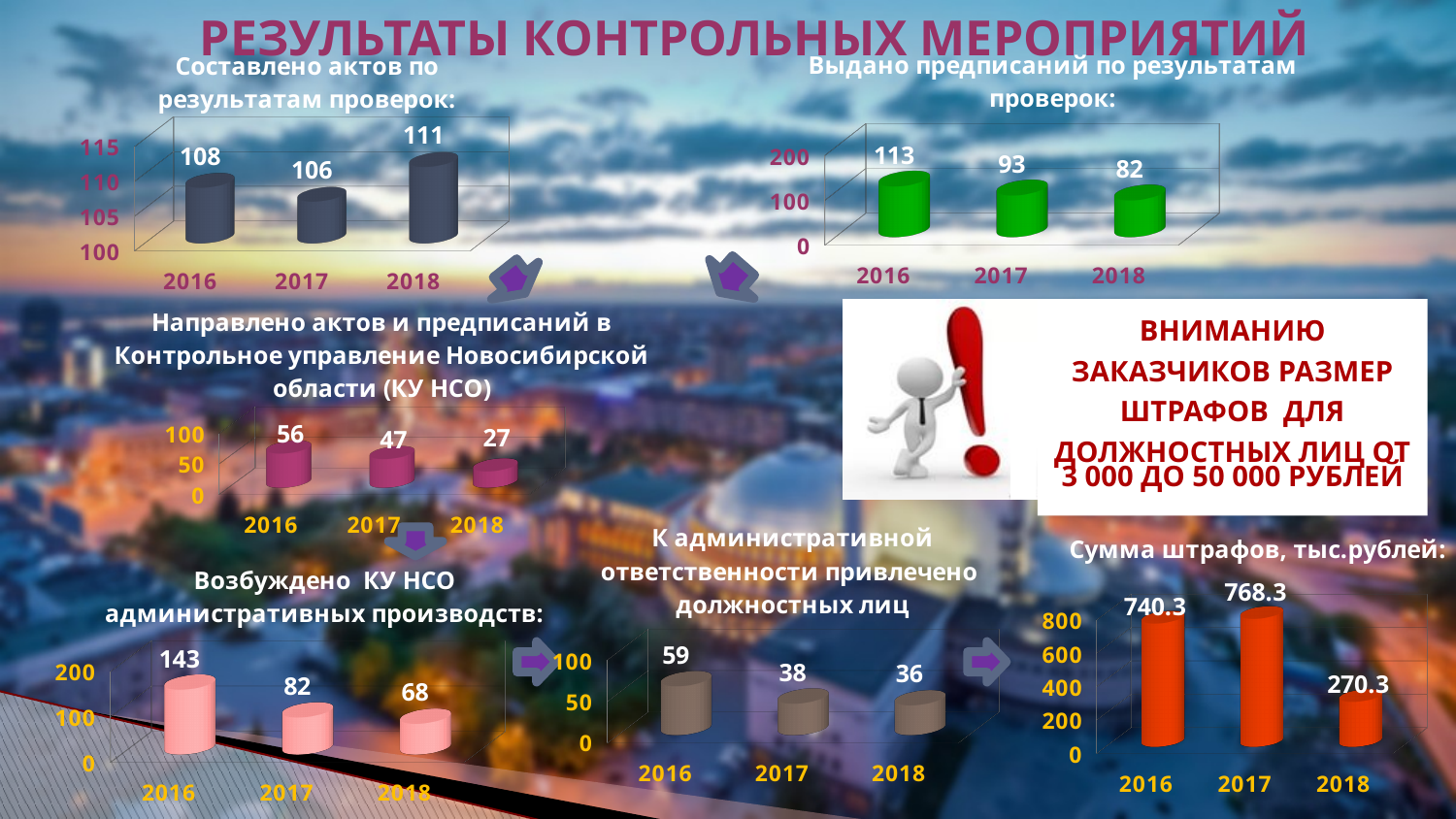
In the chart 'К административной ответственности привлечено должностных лиц', what is the value for 2018? 36 In the chart 'Составлено актов по результатам проверок', what is the value for 2018? 111 In the chart 'Направлено актов и предписаний в Контрольное управление Новосибирской области (КУ НСО)', do the values rise or fall from 2016 to 2018? fall In the chart 'Выдано предписаний по результатам проверок', what is the difference between the 2016 and 2018 values? 31 In the chart 'Сумма штрафов, тыс.рублей', which year has the highest value? 2017 In the chart 'Возбуждено КУ НСО административных производств', which year has the highest value? 2016 In the chart 'Возбуждено КУ НСО административных производств', what is the difference between the 2016 and 2017 values? 61 In the chart 'Выдано предписаний по результатам проверок', what is the value for 2016? 113 In the chart 'Направлено актов и предписаний в Контрольное управление Новосибирской области (КУ НСО)', what is the value for 2017? 47 How many charts are shown on the slide? 6 In the chart 'Сумма штрафов, тыс.рублей', is the value for 2018 greater or less than 400? less In the chart 'Составлено актов по результатам проверок', which year has the lowest value? 2017